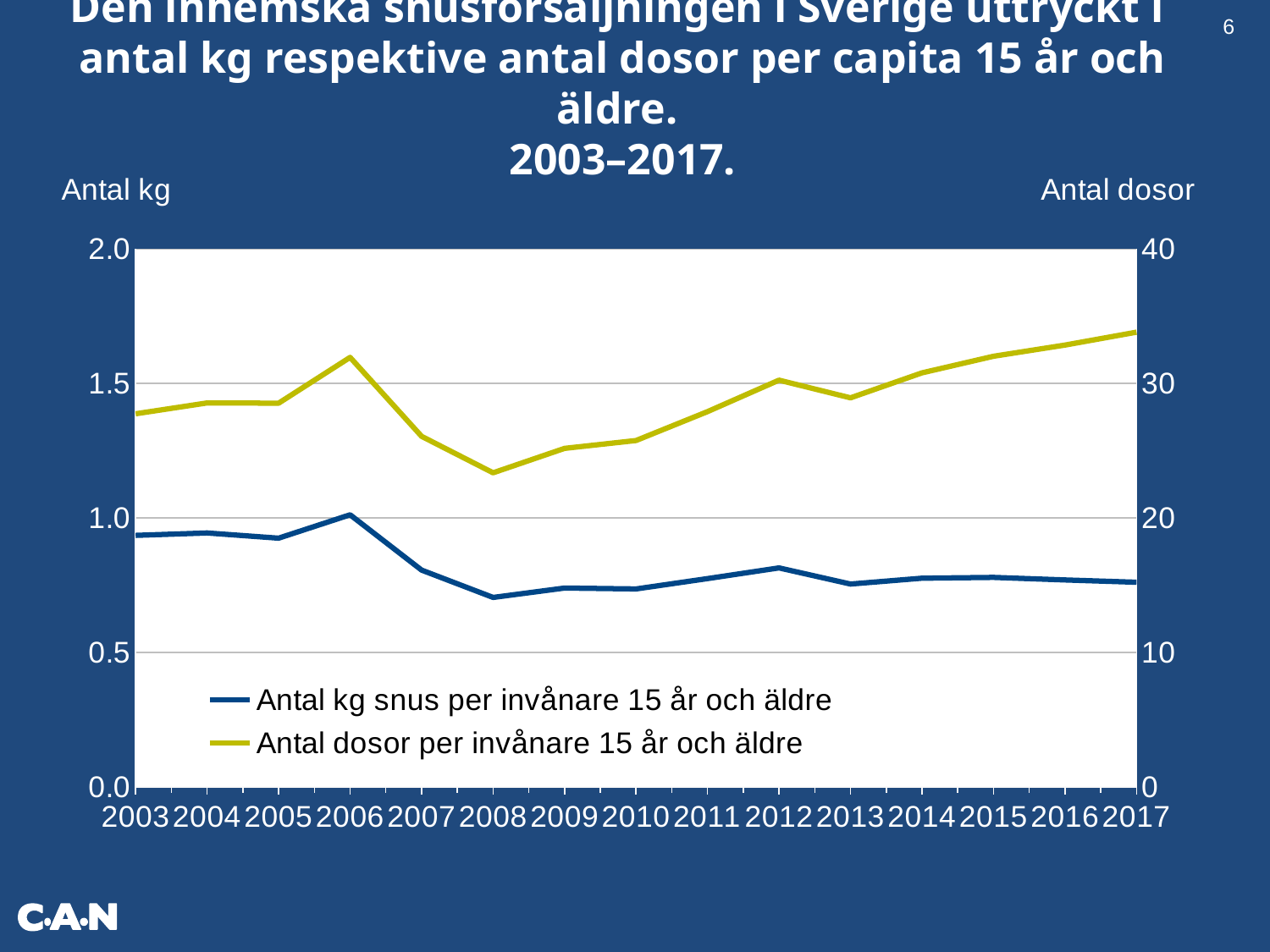
What is the label of the right-hand vertical axis? Antal dosor In which year does the series 'Antal dosor per invånare 15 år och äldre' reach its lowest value? 2008 In which year does the series 'Antal kg snus per invånare 15 år och äldre' reach its highest value? 2006 What kind of chart is shown on the slide? line chart How many series does the legend list? 2 In which year does the series 'Antal kg snus per invånare 15 år och äldre' reach its lowest value? 2008 Does the series 'Antal dosor per invånare 15 år och äldre' rise or fall from 2008 to 2017? rise Is the value for 'Antal dosor per invånare 15 år och äldre' in 2017 greater or less than 30? greater Is the value for 'Antal kg snus per invånare 15 år och äldre' in 2008 greater or less than 1.0? less How many years are plotted along the x axis? 15 In which year does the series 'Antal dosor per invånare 15 år och äldre' reach its highest value? 2017 Which year has the larger value for 'Antal dosor per invånare 15 år och äldre', 2003 or 2017? 2017